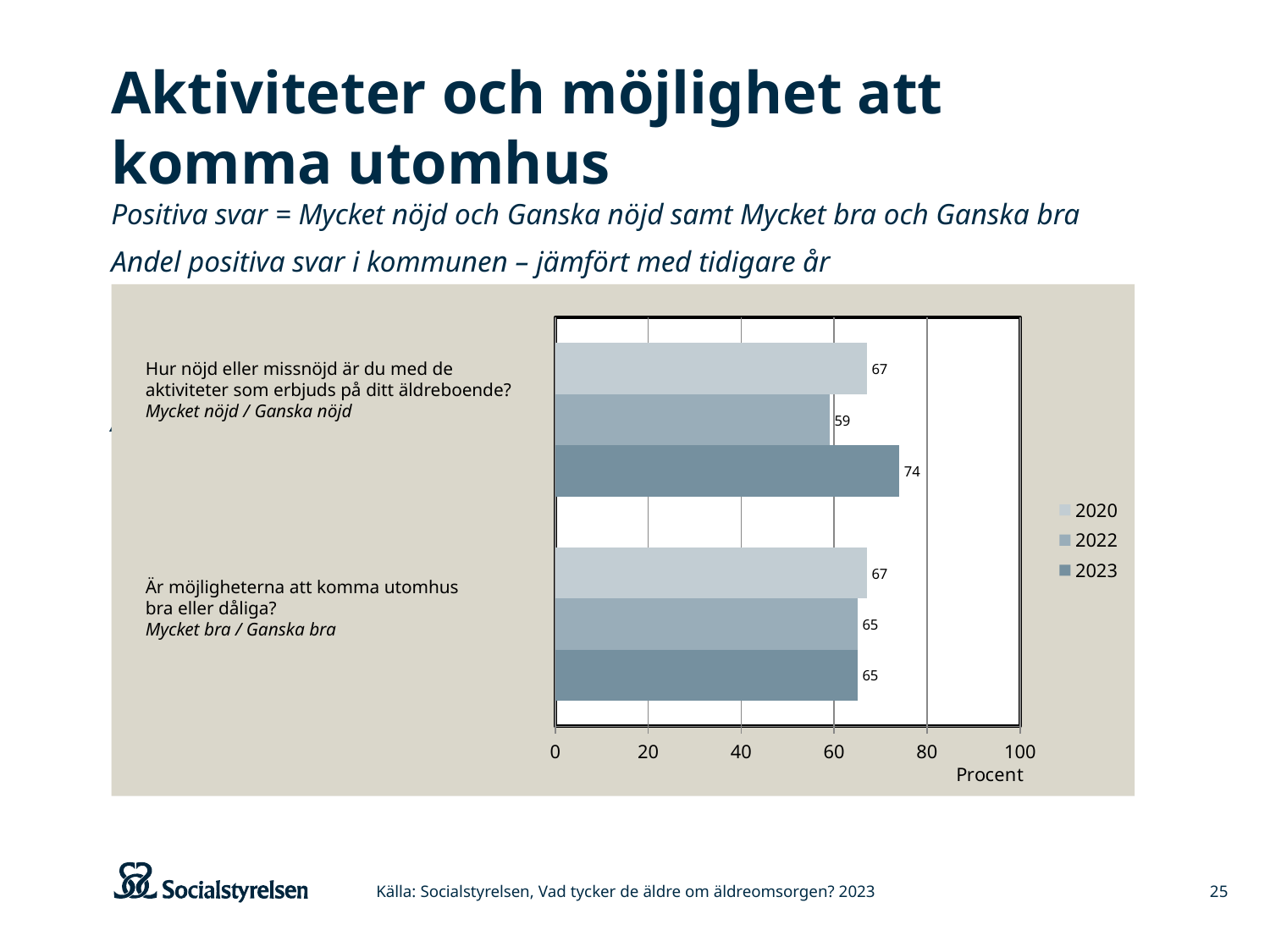
What is the 2022 value for the question about activities offered at the care home? 59 What is the difference between the 2023 and 2022 values for the question about activities offered at the care home? 15 Which year has the highest value for the question about activities offered at the care home? 2023 What is the 2020 value for the question about the possibilities to get outdoors (Är möjligheterna att komma utomhus bra eller dåliga)? 67 What label is shown on the horizontal axis of the chart? Procent How many question categories are shown on the chart? 2 What kind of chart is shown on the slide? bar chart What is the 2023 value for the question about the possibilities to get outdoors? 65 How many series does the legend list? 3 Which year has the lowest value for the question about activities offered at the care home? 2022 What is the 2023 value for the question about activities offered at the care home (Hur nöjd eller missnöjd är du med de aktiviteter som erbjuds på ditt äldreboende)? 74 Which is larger for 2023: the value for activities offered at the care home or the value for possibilities to get outdoors? activities offered at the care home